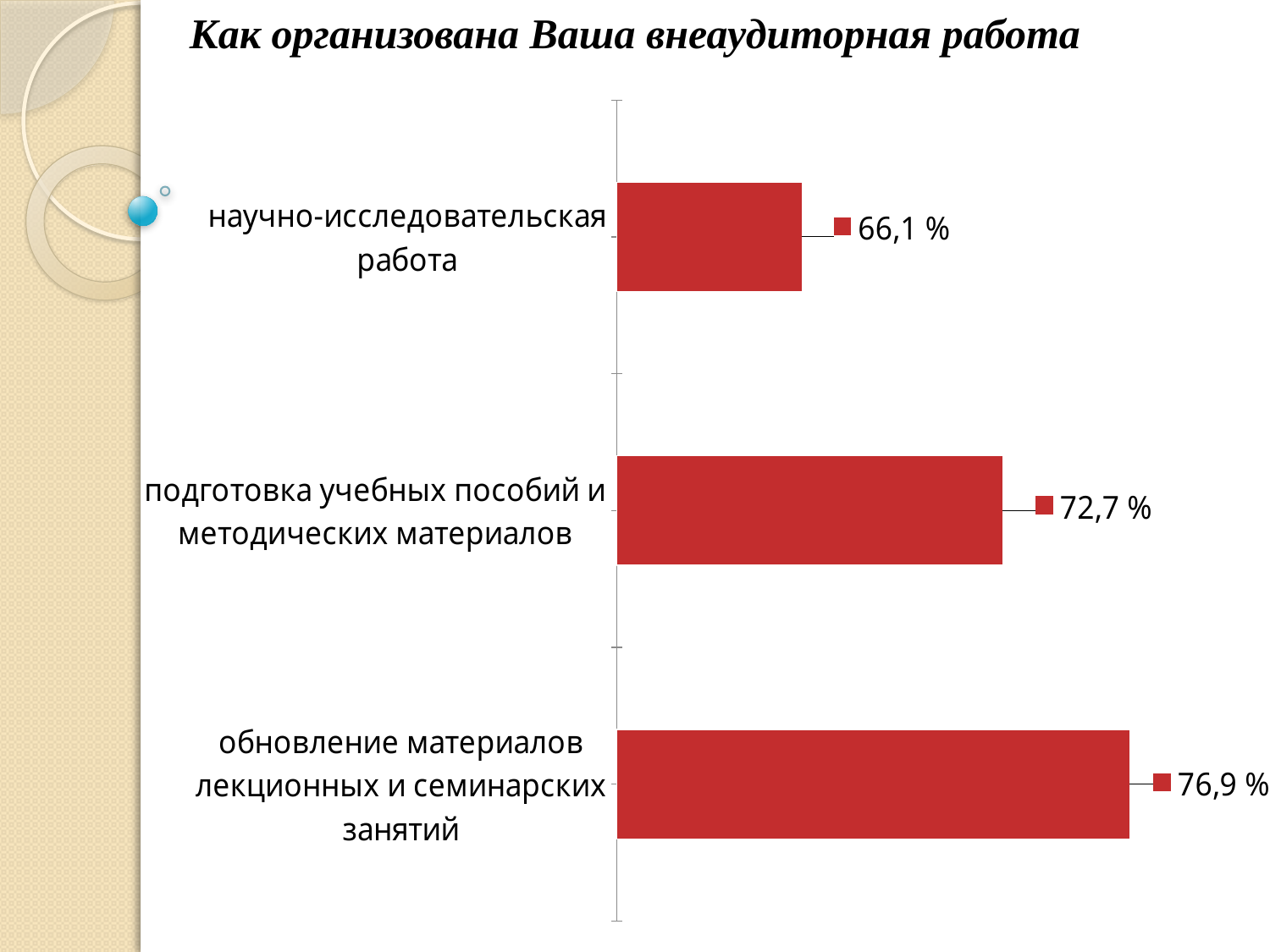
What kind of chart is shown on the slide? bar chart What is the value for «подготовка учебных пособий и методических материалов»? 72,7 % What is the difference between the values for «обновление материалов лекционных и семинарских занятий» and «научно-исследовательская работа»? 10,8 % What is the difference between the values for «обновление материалов лекционных и семинарских занятий» and «подготовка учебных пособий и методических материалов»? 4,2 % What is the value for «научно-исследовательская работа»? 66,1 % Which category has the lowest value? научно-исследовательская работа What is the value for «обновление материалов лекционных и семинарских занятий»? 76,9 % What is the title of the slide? Как организована Ваша внеаудиторная работа How many categories are shown in the chart? 3 Which category has the highest value? обновление материалов лекционных и семинарских занятий Which is larger: the value for «подготовка учебных пособий и методических материалов» or for «научно-исследовательская работа»? подготовка учебных пособий и методических материалов What is the difference between the values for «подготовка учебных пособий и методических материалов» and «научно-исследовательская работа»? 6,6 %